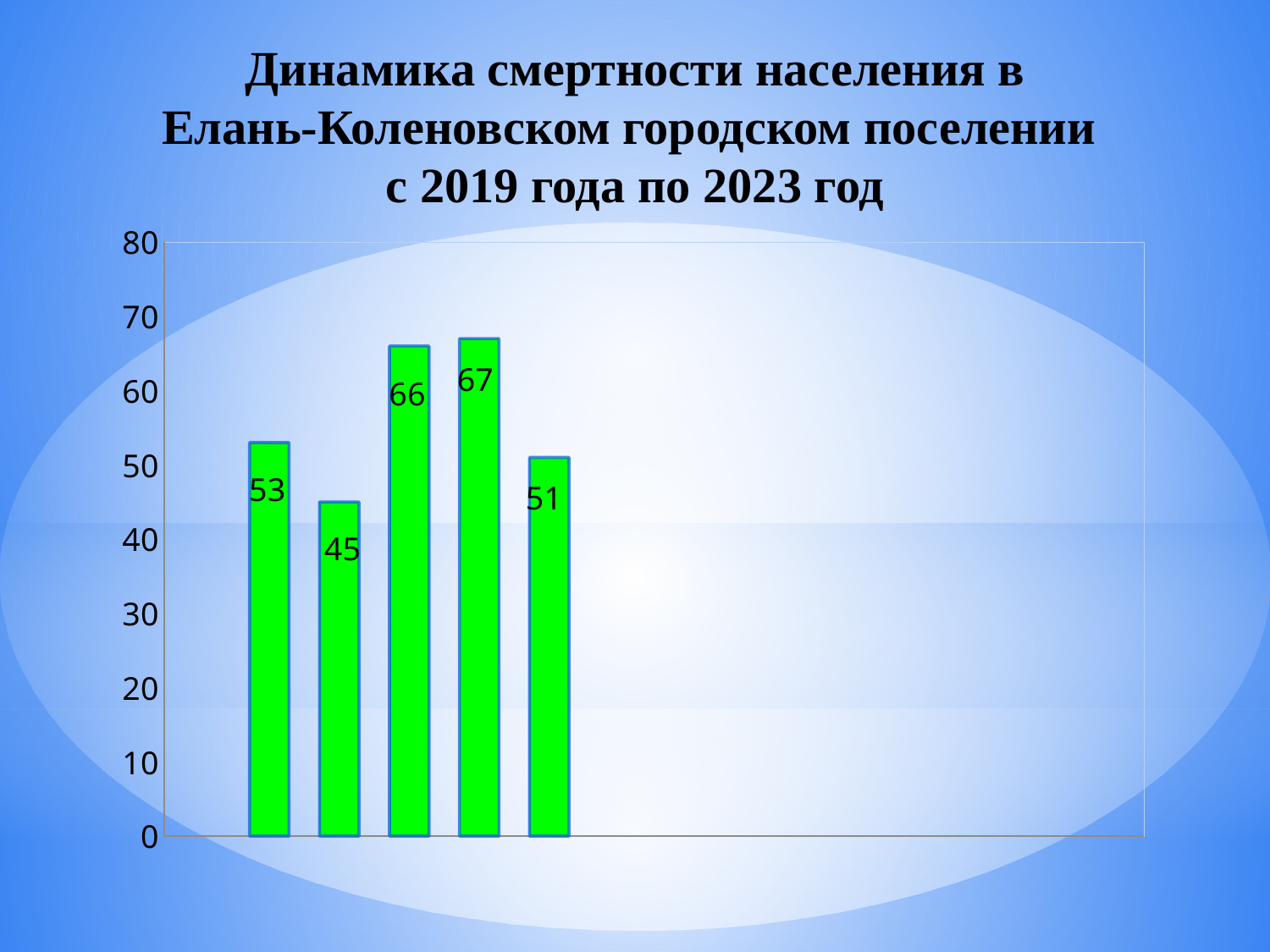
How many bars are plotted in the chart? 5 What is the difference between the fourth bar (67) and the second bar (45)? 22 What is the highest value labelled on any bar in the chart? 67 What is the value shown on the third bar from the left? 66 What is the value shown on the second bar from the left? 45 Is the value of the third bar greater or less than 60? greater What is the maximum value shown on the vertical axis? 80 What is the value shown on the last (rightmost) bar? 51 Which is larger, the value of the first bar or the value of the last bar? The first bar (53) What is the lowest value labelled on any bar in the chart? 45 What type of chart is shown on the slide? Bar chart What is the value shown on the first (leftmost) bar? 53